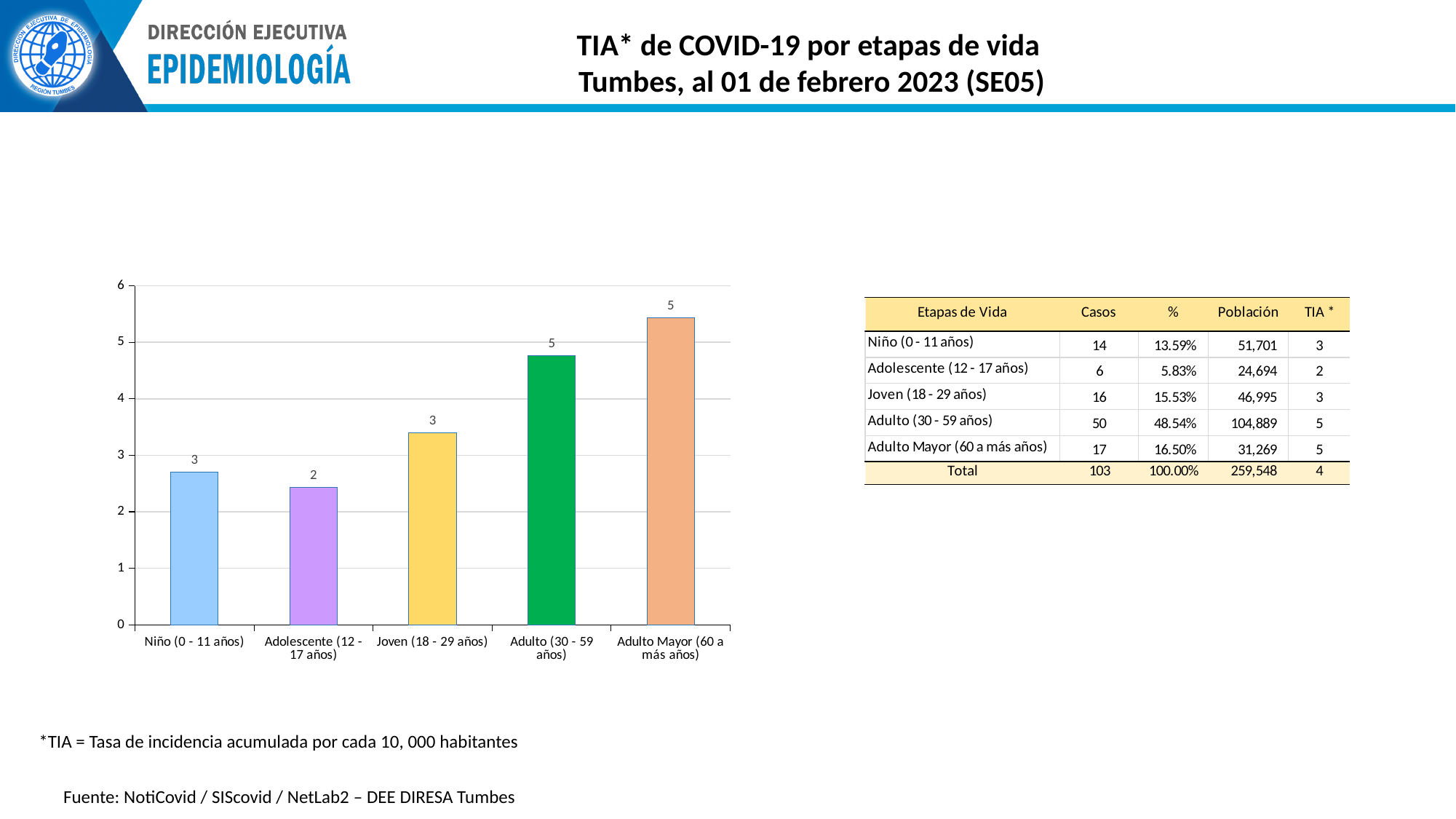
Which life stage has the tallest bar in the chart? Adulto Mayor (60 a más años) How many life-stage categories are plotted in the bar chart? 5 Which life stage has the shortest bar in the chart? Adolescente (12 - 17 años) What colour is the bar for Adulto (30 - 59 años)? Green What is the data label shown for Adulto (30 - 59 años) in the bar chart? 5 Using the data labels, what is the difference between the value for Adulto (30 - 59 años) and the value for Adolescente (12 - 17 años)? 3 Is the bar for Niño (0 - 11 años) greater or less than 3 on the axis? less What kind of chart is used to show the TIA by life stage? Bar chart What is the data label shown for Adolescente (12 - 17 años) in the bar chart? 2 Is the bar for Adulto (30 - 59 años) greater or less than 4 on the axis? greater What is the data label shown for Niño (0 - 11 años) in the bar chart? 3 Which bar is taller, Joven (18 - 29 años) or Niño (0 - 11 años)? Joven (18 - 29 años)